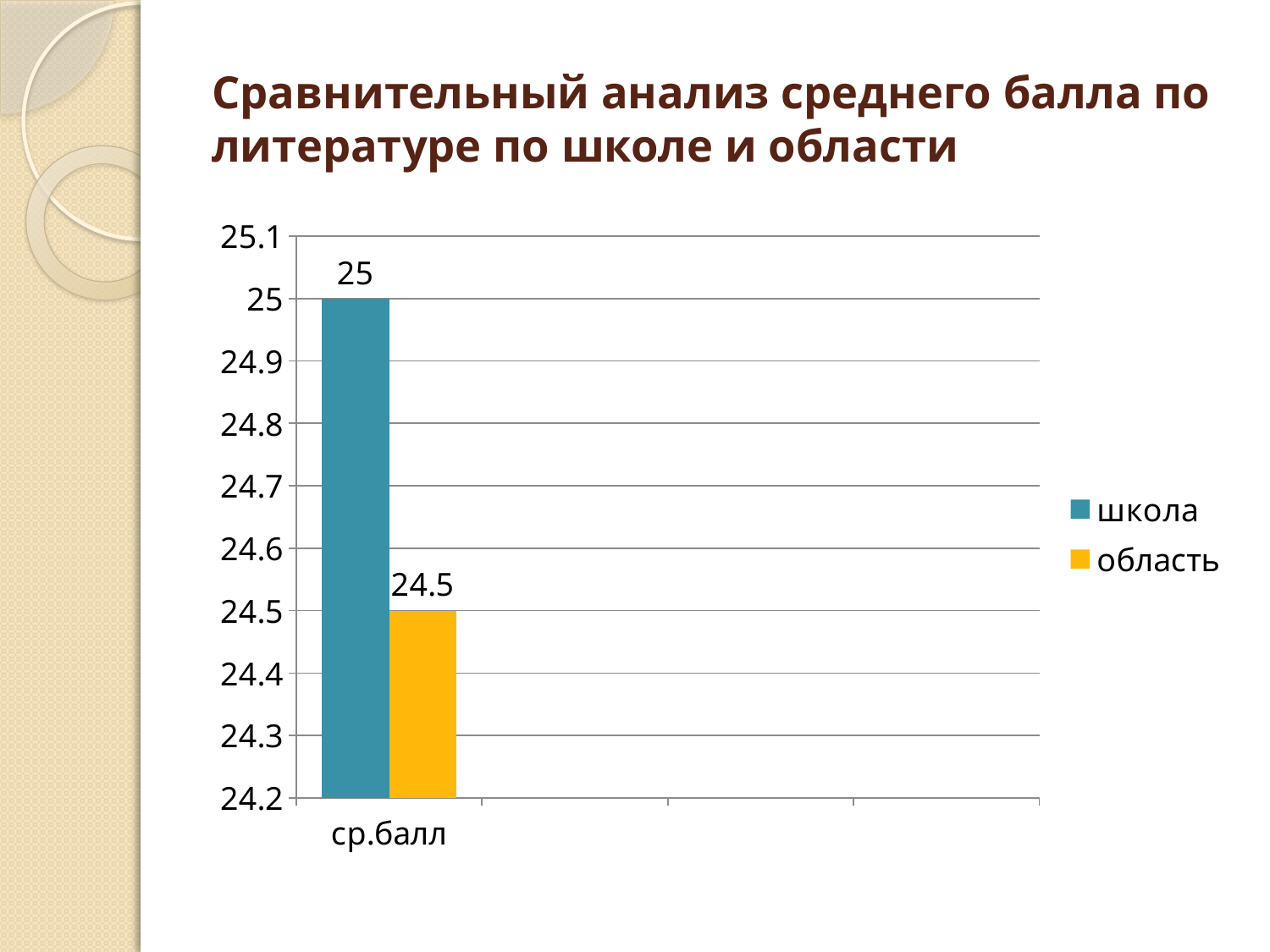
What is the difference between the школа value and the область value? 0.5 How many categories are shown on the x axis? 1 How many series does the legend list? 2 What is the title of the slide? Сравнительный анализ среднего балла по литературе по школе и области What is the value for школа in the ср.балл category? 25 Which series has the higher value: школа or область? школа What colour is the bar for область? yellow Is the value for школа greater or less than 24.6? greater Which series has the lowest value on the chart? область What is the value for область in the ср.балл category? 24.5 Is the value for область greater or less than 24.8? less What kind of chart is shown on the slide? bar chart